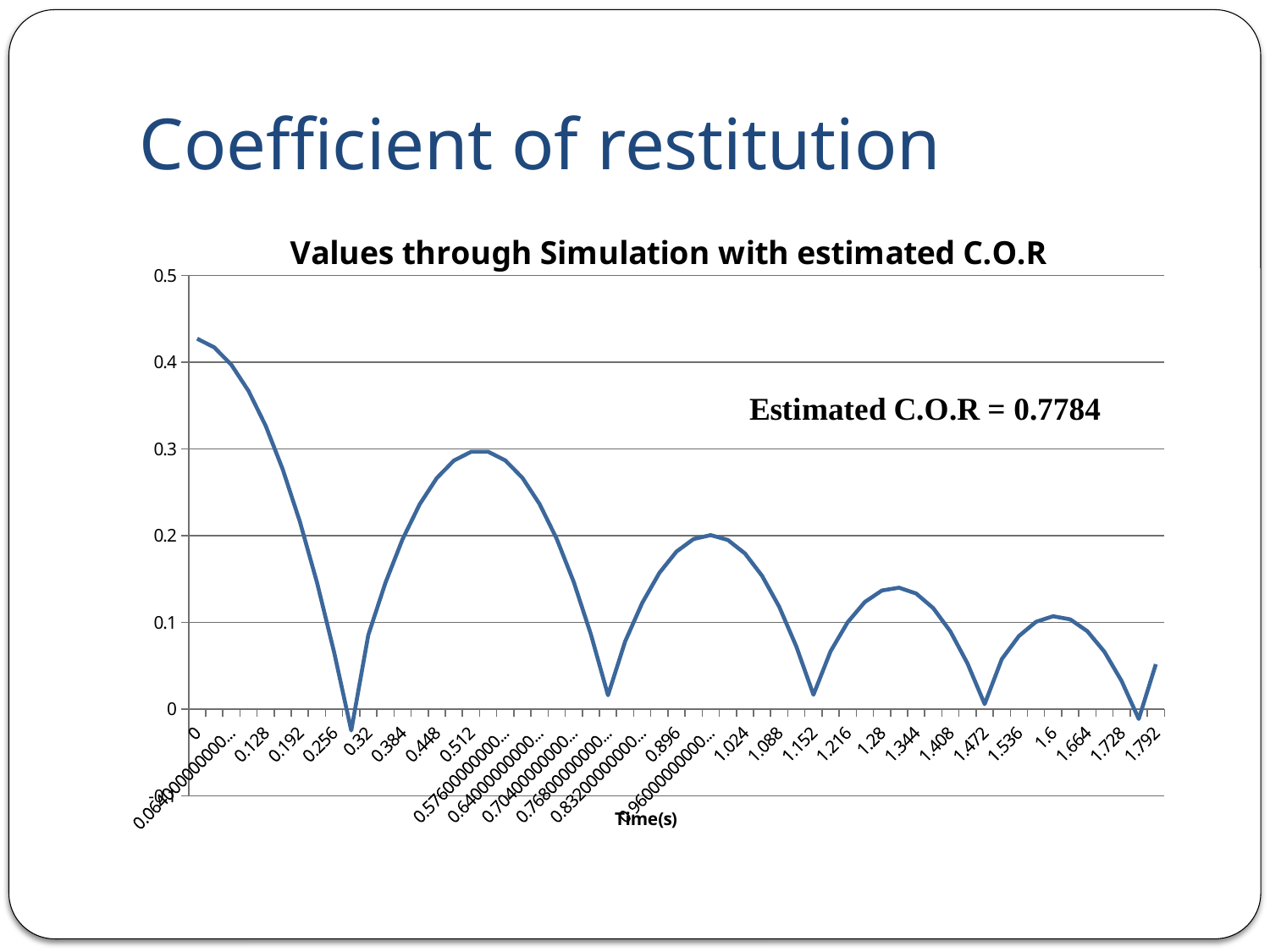
Which is larger: the value at time 0 or the value at time 1.792? the value at time 0 Do the successive peaks of the line rise or fall as time increases? fall Is the value at time 0.128 greater or less than 0.3? greater What estimated C.O.R value is printed on the chart? 0.7784 Is the value at time 0 greater or less than 0.4? greater Is the peak of the line near time 0.512 greater or less than 0.2? greater What kind of chart is shown on the slide? line chart Which is larger: the peak near time 0.512 or the peak near time 0.96? the peak near 0.512 What is the title of the chart? Values through Simulation with estimated C.O.R